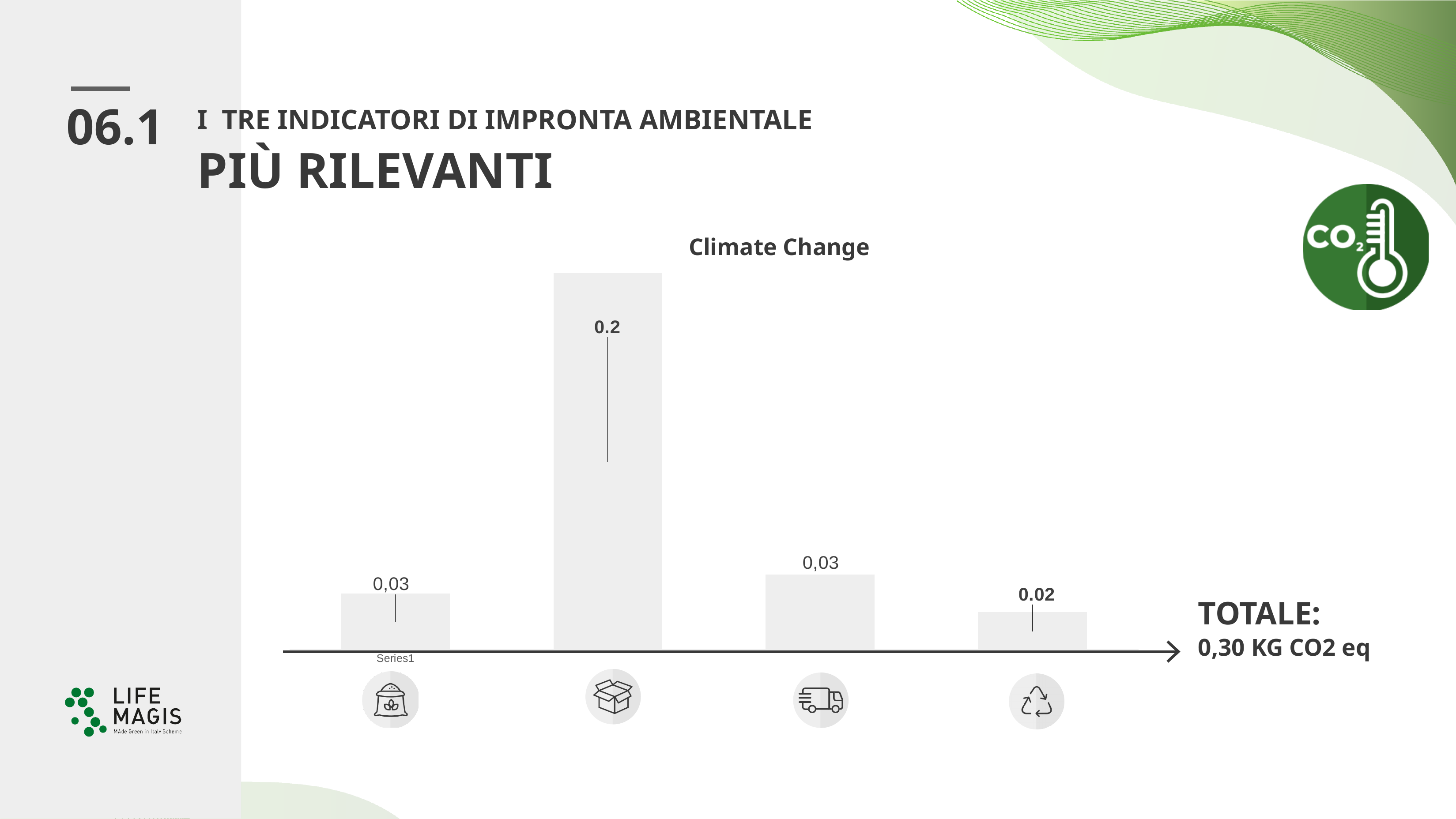
In the Climate Change chart, what is the value of the second bar (the one above the box icon)? 0.2 Which bar in the Climate Change chart has the lowest value? the fourth bar (recycling icon) What kind of chart is shown under the title "Climate Change"? bar chart What is the title of the chart on the slide? Climate Change In the Climate Change chart, is the second bar (box icon) larger or smaller than the third bar (truck icon)? larger In the Climate Change chart, what is the difference between the second bar (0.2) and the fourth bar (0.02)? 0.18 In the Climate Change chart, what is the value of the third bar (the one above the truck icon)? 0,03 How many bars are plotted in the Climate Change chart? 4 Which bar in the Climate Change chart has the highest value? the second bar (box icon) In the Climate Change chart, what is the value of the first bar (the one above the sack icon)? 0,03 What total value is stated next to the Climate Change chart? 0,30 KG CO2 eq In the Climate Change chart, what is the value of the fourth bar (the one above the recycling icon)? 0.02